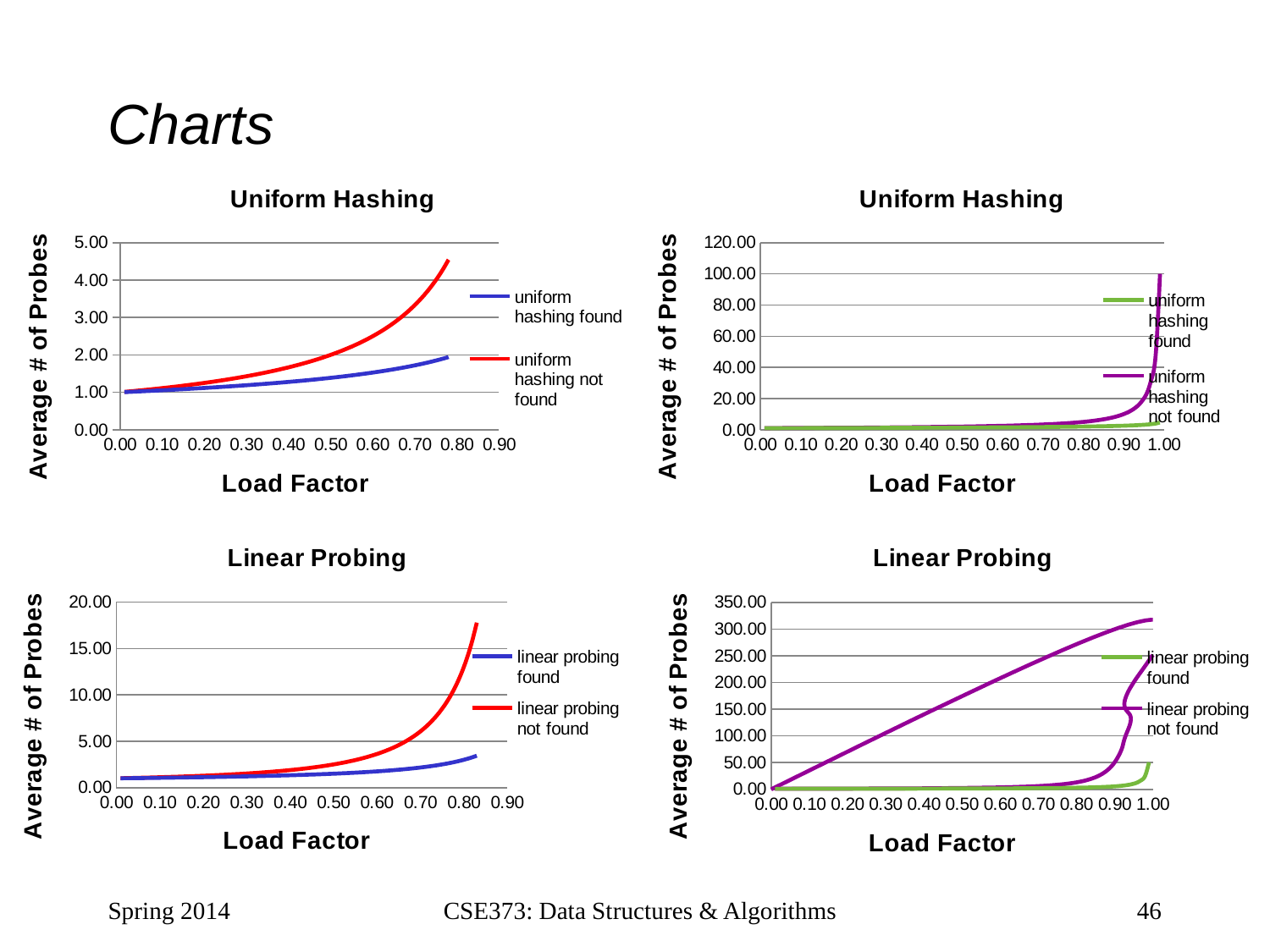
How many series does the legend of the bottom-left Linear Probing chart list? 2 In the top-left Uniform Hashing chart, does the uniform hashing not found series rise or fall as the load factor increases? rise In the top-left Uniform Hashing chart, is the value for uniform hashing not found at load factor 0.70 greater or less than 2.00? greater What is the y-axis title of the top-left Uniform Hashing chart? Average # of Probes In the bottom-left Linear Probing chart, does the linear probing found series rise or fall as the load factor increases? rise In the top-right Uniform Hashing chart, is the value for uniform hashing found at load factor 0.90 greater or less than 20.00? less How many series does the legend of the top-left Uniform Hashing chart list? 2 In the bottom-left Linear Probing chart, is the value for linear probing not found at load factor 0.80 greater or less than 5.00? greater How many charts are shown on the slide? 4 In the top-left Uniform Hashing chart, which series is higher at load factor 0.70, uniform hashing found or uniform hashing not found? uniform hashing not found What kind of chart is the top-left Uniform Hashing chart? line chart